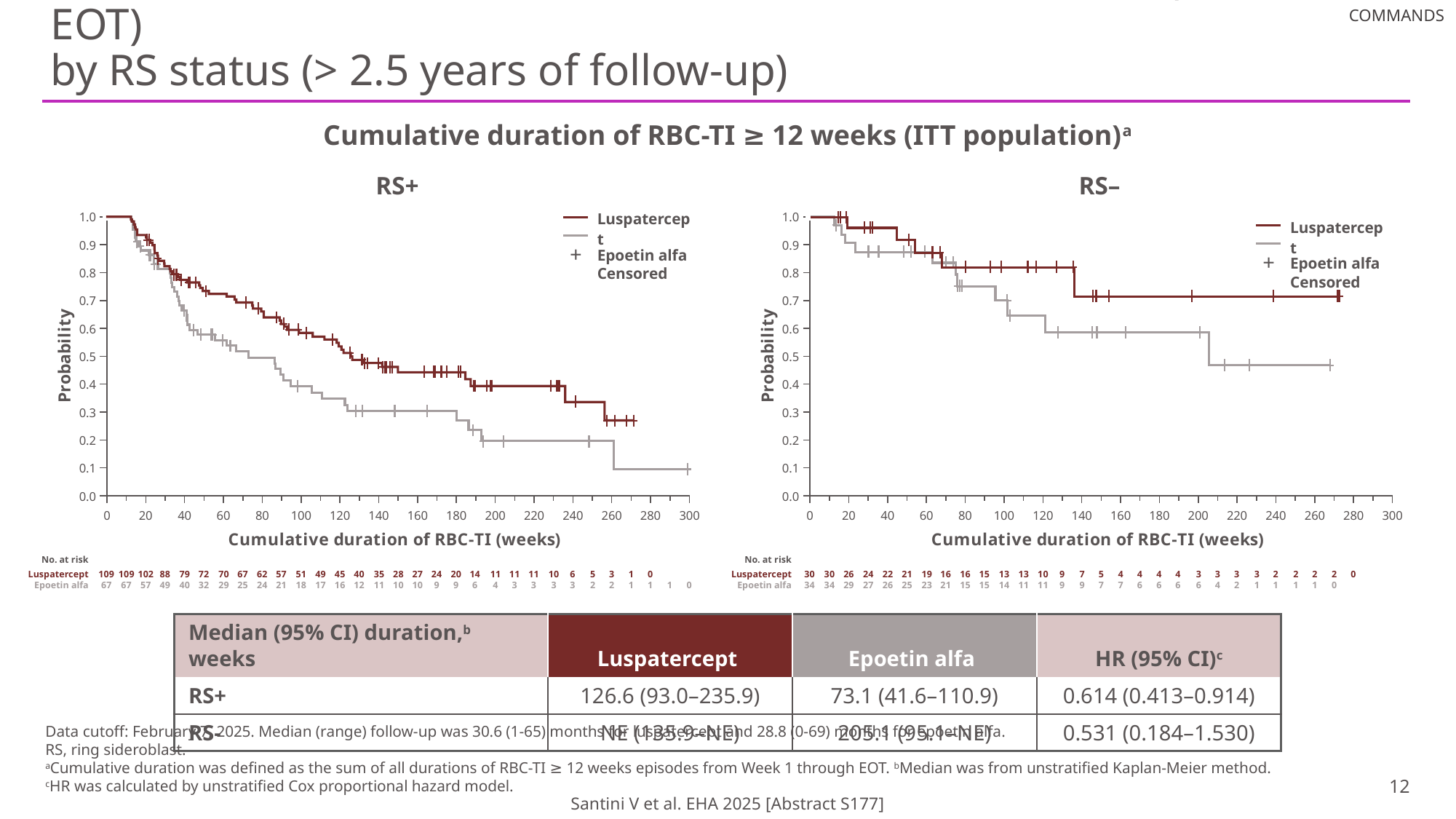
How many treatment series does the legend of the RS– chart list? 2 In the RS+ chart, what is the number at risk for Epoetin alfa at week 0? 67 In the RS– chart, what is the number at risk for Epoetin alfa at week 0? 34 In the RS+ chart, what is the number at risk for Luspatercept at week 0? 109 In the RS– chart, what is the number at risk for Luspatercept at week 0? 30 In the RS+ chart, is the Epoetin alfa probability at week 200 greater or less than 0.3? less In the RS– chart, do the probability curves rise or fall as cumulative duration increases? Fall In the RS– chart, is the Luspatercept probability at week 200 greater or less than 0.6? greater What kind of chart is the RS+ chart? Line chart (Kaplan-Meier curve) In the RS+ chart, which series has the higher probability at week 100, Luspatercept or Epoetin alfa? Luspatercept What is the label of the x axis on the RS+ chart? Cumulative duration of RBC-TI (weeks)